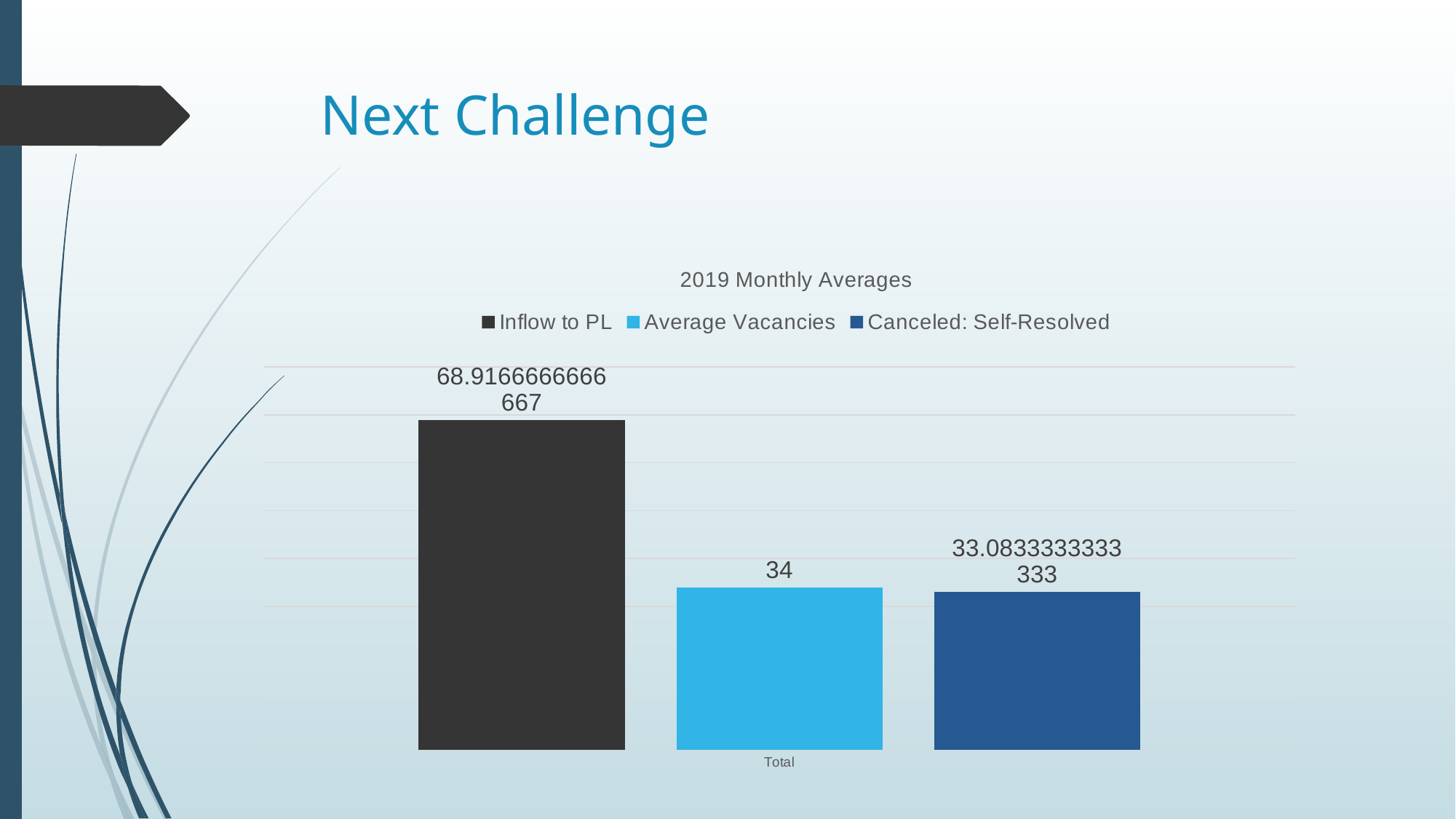
What is the difference between the Inflow to PL value and the Average Vacancies value? 34.9166666666667 What is the value of the Canceled: Self-Resolved bar? 33.0833333333333 What kind of chart is shown on the slide? Bar chart What is the value of the Inflow to PL bar in the 2019 Monthly Averages chart? 68.9166666666667 Which is larger, Average Vacancies or Canceled: Self-Resolved? Average Vacancies What is the title of the chart? 2019 Monthly Averages Which is larger, Inflow to PL or Average Vacancies? Inflow to PL Which series has the lowest value in the chart? Canceled: Self-Resolved How many bars are plotted in the chart? 3 Which series has the highest value in the chart? Inflow to PL How many series does the legend list? 3 What is the value of the Average Vacancies bar? 34